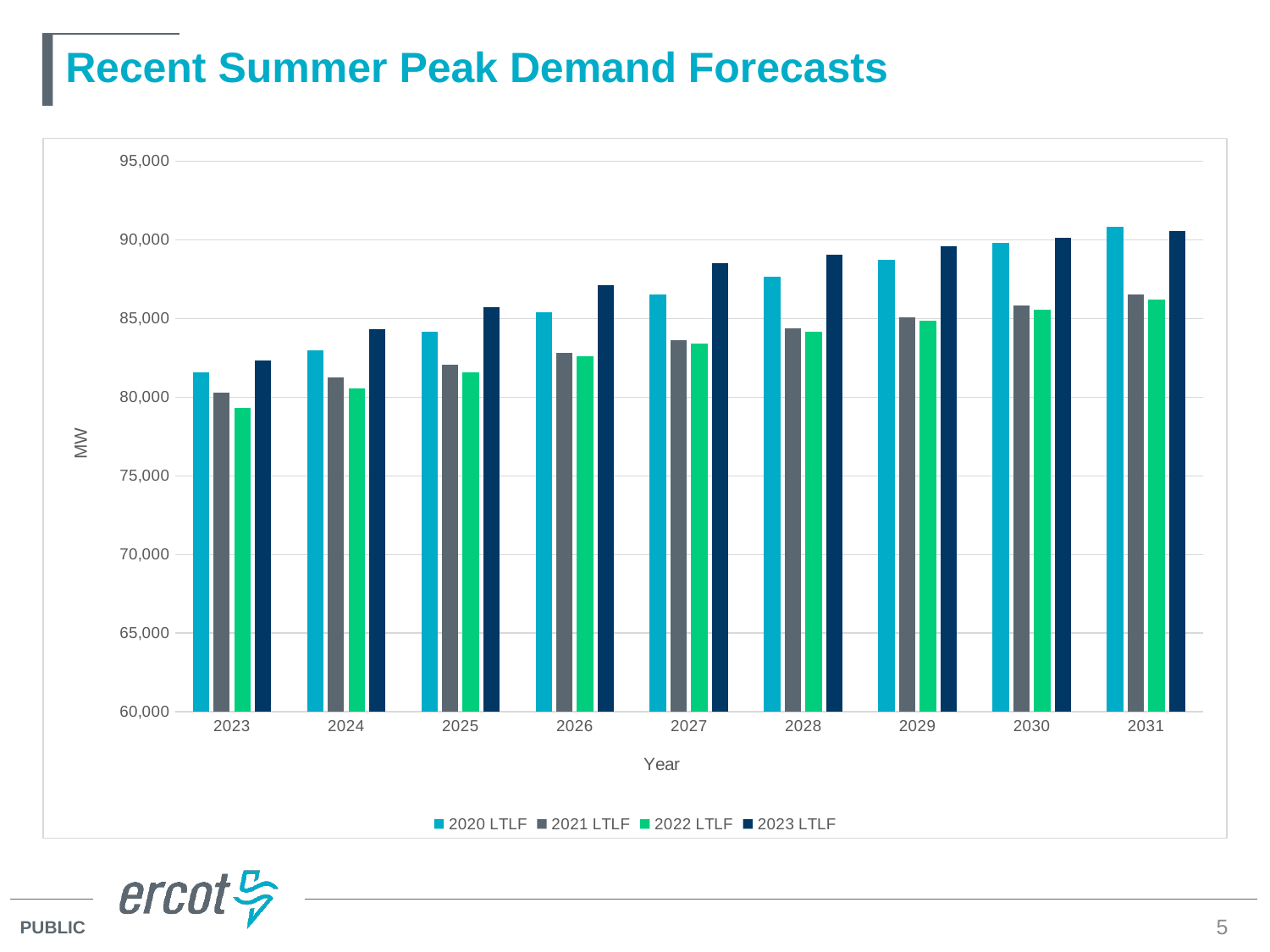
How many series does the legend list? 4 Is the 2023 LTLF value for 2026 greater or less than 85,000? greater For 2023, which is larger: the 2023 LTLF value or the 2022 LTLF value? 2023 LTLF Is the 2022 LTLF value for 2023 greater or less than 80,000? less How many years are shown on the x axis? 9 Is the 2021 LTLF value for 2027 greater or less than 85,000? less What kind of chart is shown on the slide? bar chart For 2023, which series has the lowest value? 2022 LTLF For 2031, which is larger: the 2020 LTLF value or the 2021 LTLF value? 2020 LTLF What is the label on the y axis? MW Do the 2023 LTLF values rise or fall from 2023 to 2031? rise